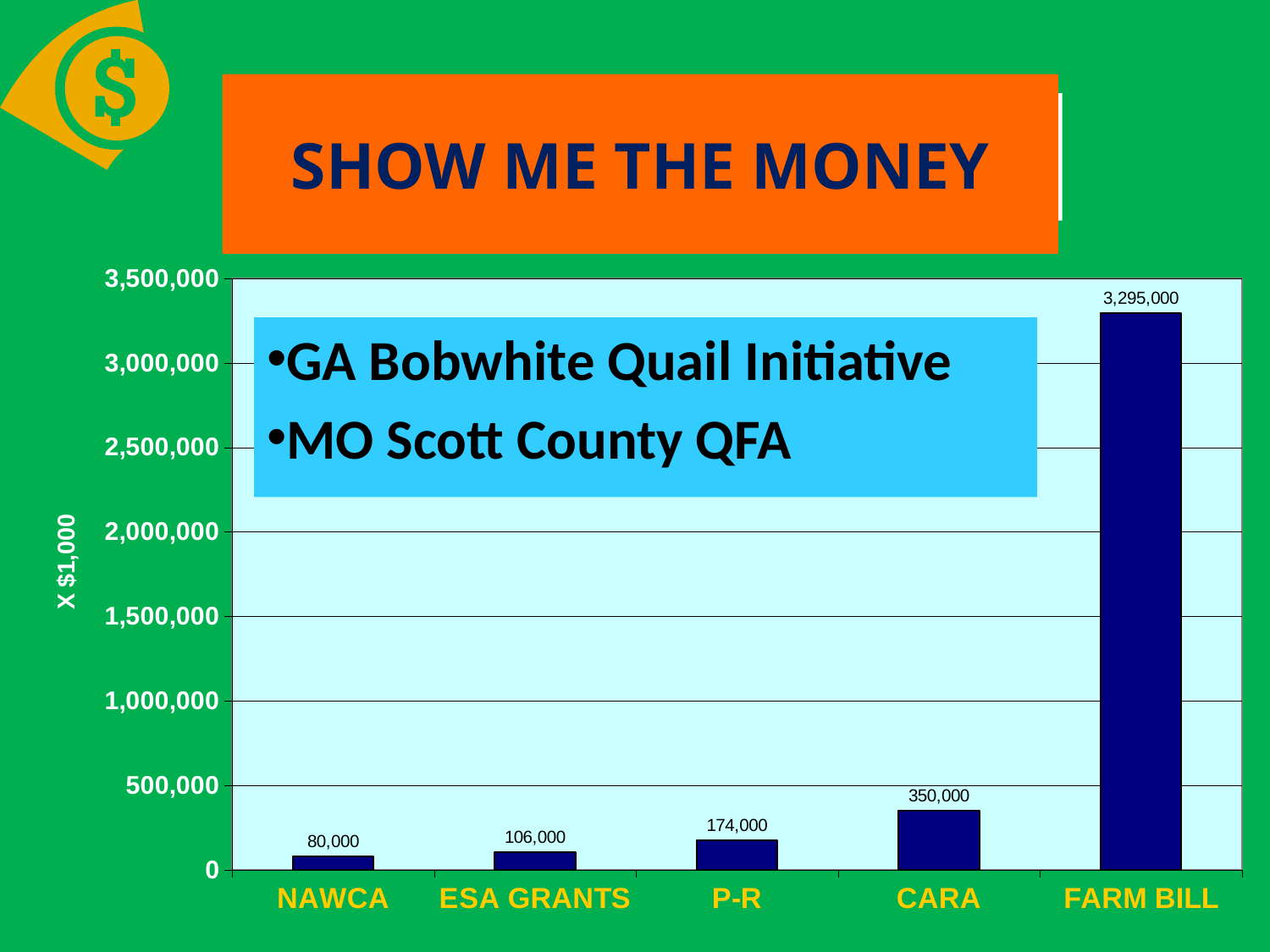
What is the difference between the values for CARA and P-R? 176,000 Is the value for CARA greater or less than 500,000? less What is the value for P-R? 174,000 Which category has the highest value? FARM BILL Which category has the lowest value? NAWCA What kind of chart is shown on the slide? bar chart What is the value for FARM BILL? 3,295,000 What is the value for NAWCA? 80,000 Which is larger, the value for ESA GRANTS or the value for P-R? P-R What is the value for CARA? 350,000 What is the label on the vertical axis? X $1,000 How many categories are shown on the x axis? 5